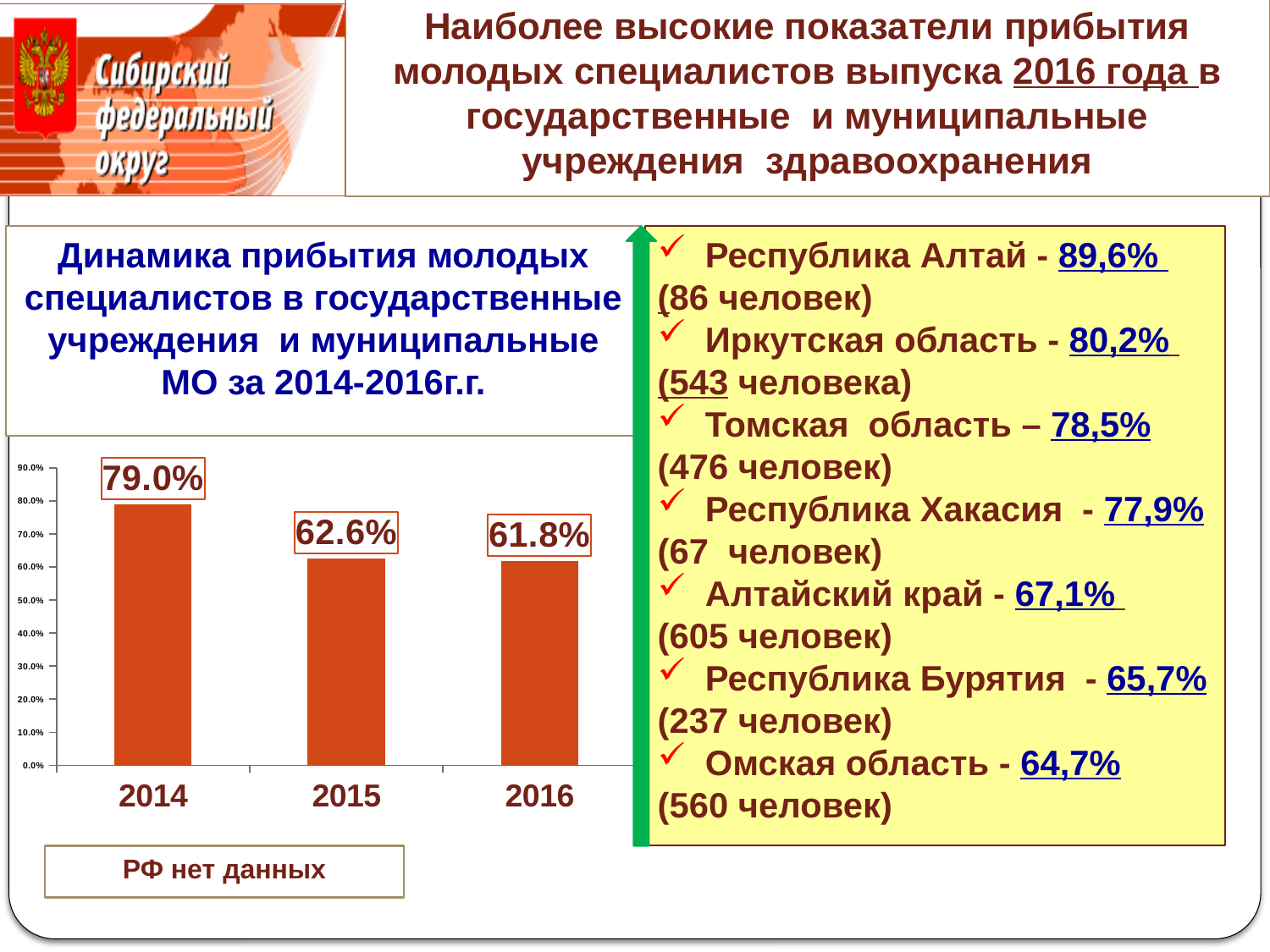
Which is larger in the bar chart, the value for 2014 or the value for 2016? 2014 What is the difference between the values for 2014 and 2015 in the bar chart? 16.4% Which year has the highest value in the bar chart? 2014 Is the value for 2015 in the bar chart greater or less than 70.0%? less What is the difference between the values for 2014 and 2016 in the bar chart? 17.2% What is the value shown for 2014 in the bar chart? 79.0% What kind of chart is shown on the slide? bar chart What is the value shown for 2015 in the bar chart? 62.6% Which year has the lowest value in the bar chart? 2016 What is the value shown for 2016 in the bar chart? 61.8% Do the values in the bar chart rise or fall from 2014 to 2016? fall How many years (bars) are shown in the bar chart? 3